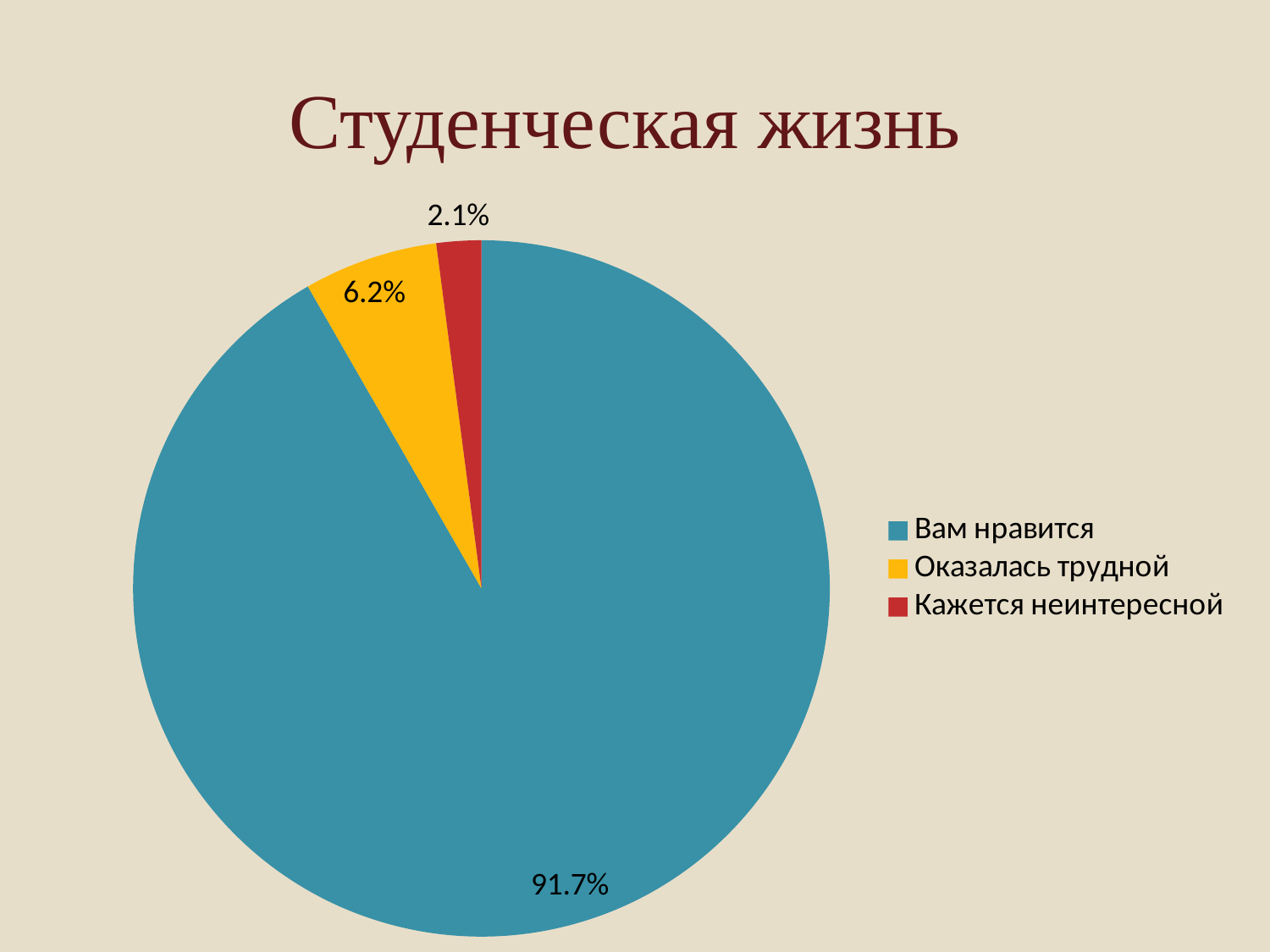
What is the value for "Кажется неинтересной"? 2.1% What kind of chart is shown on the slide? pie chart Which is larger, the value for "Оказалась трудной" or the value for "Кажется неинтересной"? Оказалась трудной What is the title of the slide? Студенческая жизнь What is the value for "Вам нравится"? 91.7% What is the difference between the values for "Вам нравится" and "Оказалась трудной"? 85.5% What is the value for "Оказалась трудной"? 6.2% Which category has the smallest share of the pie? Кажется неинтересной What colour is the slice for "Оказалась трудной"? yellow How many categories does the pie chart have? 3 Which category has the largest share of the pie? Вам нравится What is the difference between the values for "Оказалась трудной" and "Кажется неинтересной"? 4.1%